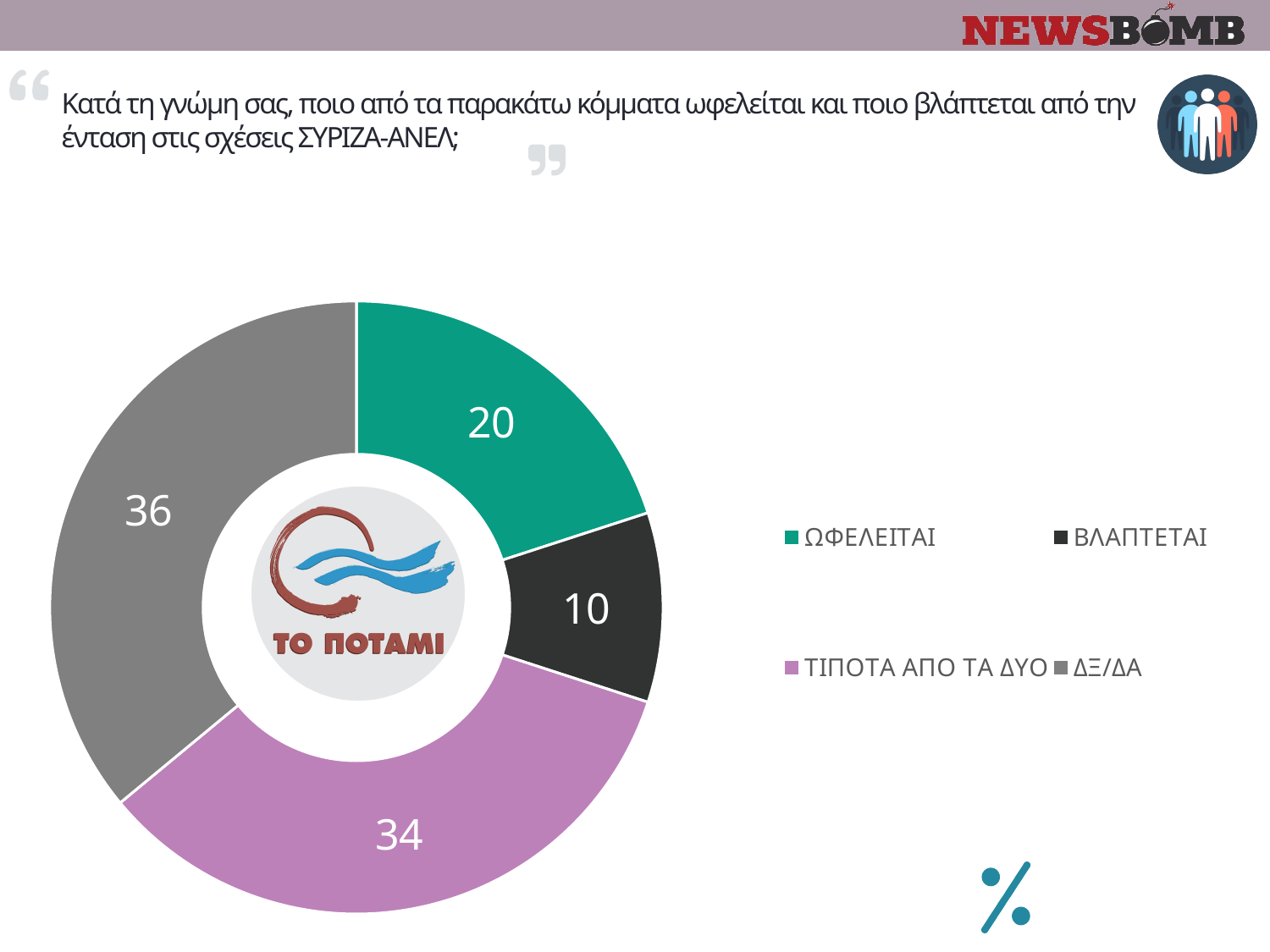
What share of the chart does the ΒΛΑΠΤΕΤΑΙ slice represent? 10% Which colour represents ΤΙΠΟΤΑ ΑΠΟ ΤΑ ΔΥΟ in the chart? Purple What is the value for ΩΦΕΛΕΙΤΑΙ? 20 Which is larger, the value for ΤΙΠΟΤΑ ΑΠΟ ΤΑ ΔΥΟ or the value for ΩΦΕΛΕΙΤΑΙ? ΤΙΠΟΤΑ ΑΠΟ ΤΑ ΔΥΟ What is the value for ΒΛΑΠΤΕΤΑΙ? 10 What is the value for ΤΙΠΟΤΑ ΑΠΟ ΤΑ ΔΥΟ? 34 How many categories does the chart show? 4 What is the difference between the values for ΩΦΕΛΕΙΤΑΙ and ΒΛΑΠΤΕΤΑΙ? 10 Which category has the lowest value? ΒΛΑΠΤΕΤΑΙ What is the value for ΔΞ/ΔΑ? 36 What kind of chart is shown on the slide? Doughnut (pie) chart Which category has the highest value? ΔΞ/ΔΑ